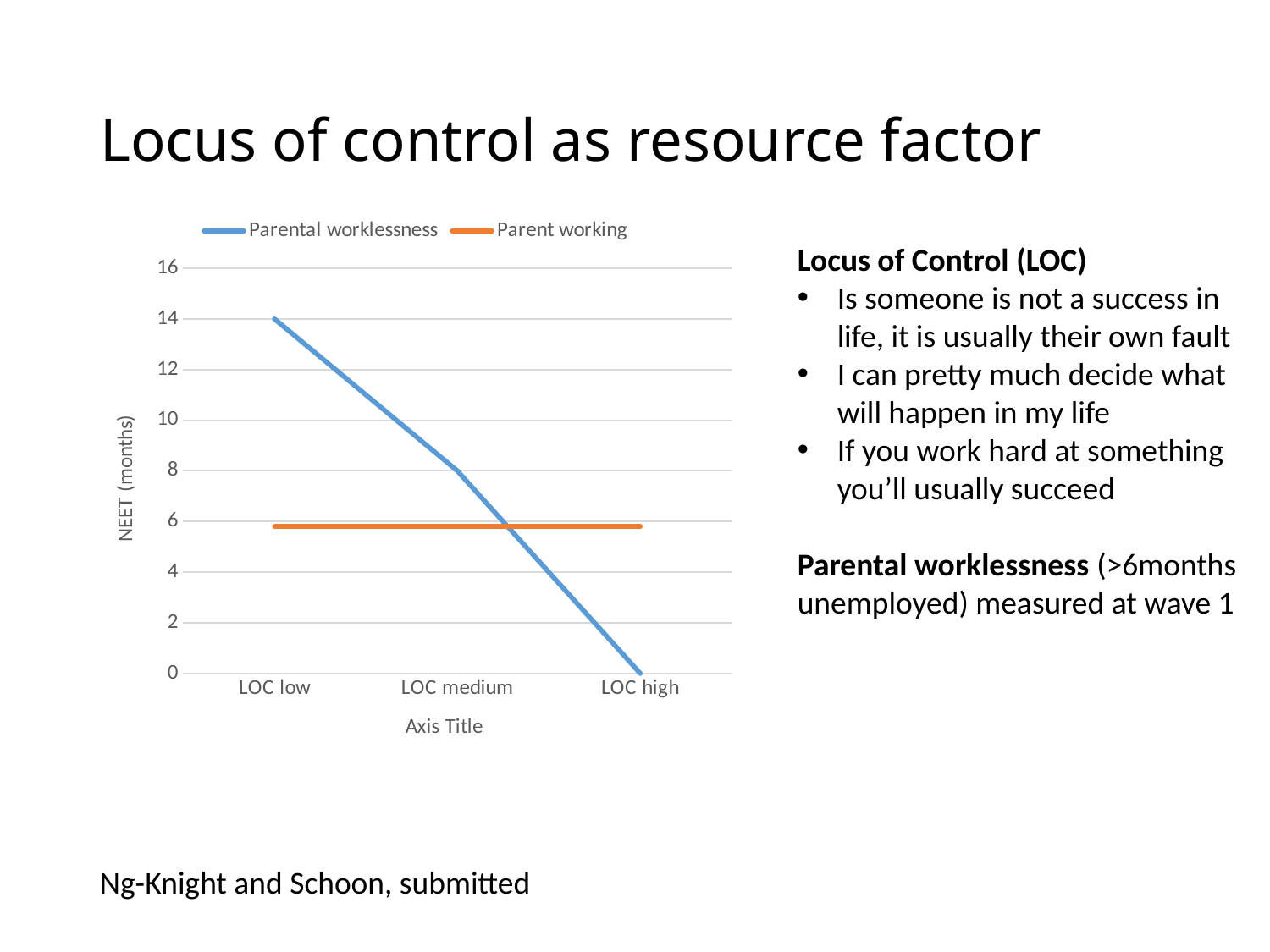
How many series does the chart's legend list? 2 What is the NEET (months) value for Parental worklessness at LOC low? 14 What is the difference in NEET (months) for Parental worklessness between LOC low and LOC medium? 6 What kind of chart is shown on the slide? line chart At LOC low, which series has the higher NEET (months) value, Parental worklessness or Parent working? Parental worklessness Is the value for Parent working at LOC medium greater or less than 4? greater Does the Parental worklessness line rise or fall from LOC low to LOC high? fall What is the NEET (months) value for Parental worklessness at LOC medium? 8 For the Parental worklessness series, which LOC category has the highest NEET (months) value? LOC low For the Parental worklessness series, which LOC category has the lowest NEET (months) value? LOC high How many categories are shown on the x axis of the chart? 3 What is the NEET (months) value for Parental worklessness at LOC high? 0